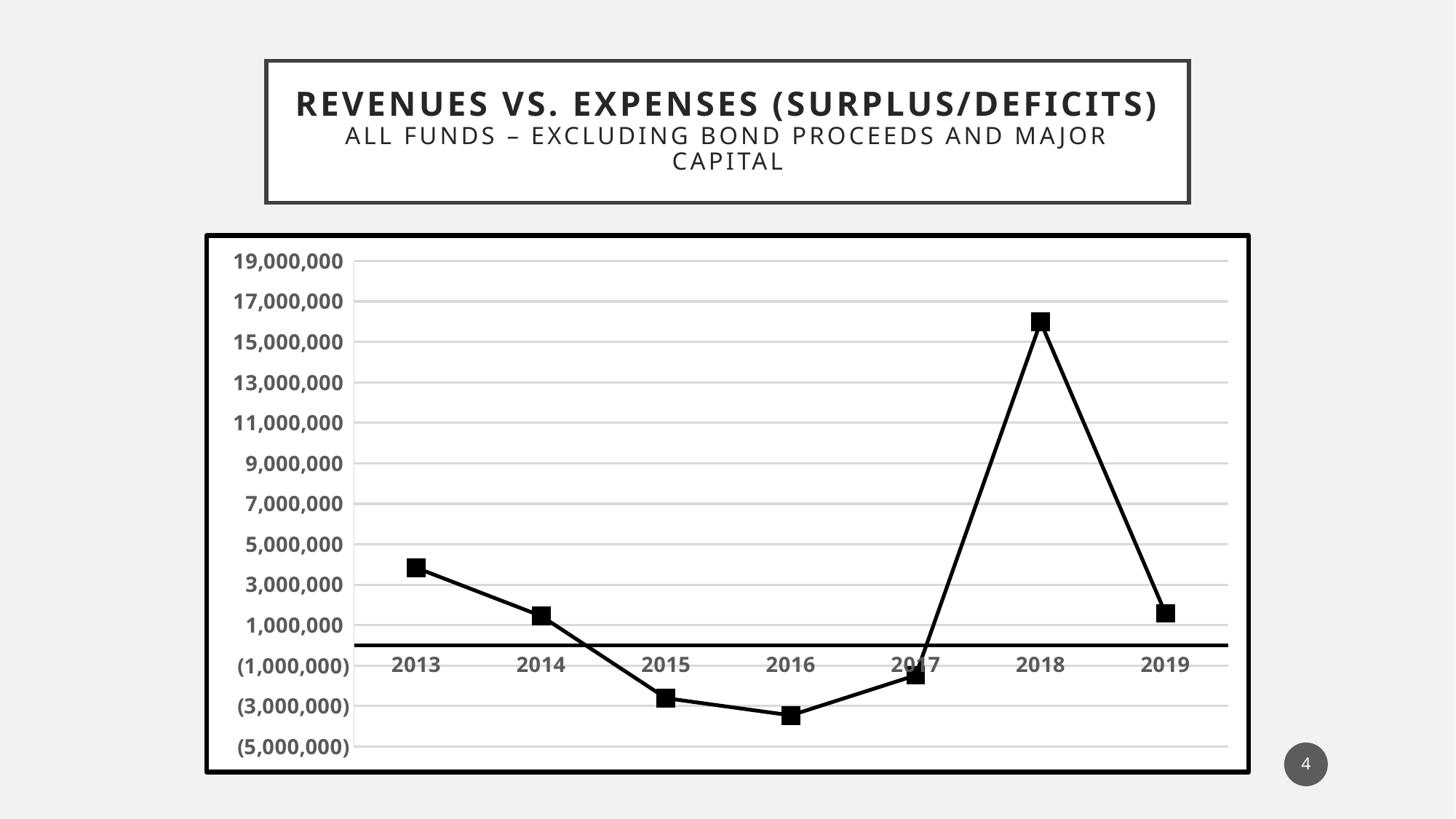
Is the value for 2015 greater or less than 1,000,000? less Which year has the highest value? 2018 Is the value for 2013 greater or less than 3,000,000? greater Is the value for 2016 greater or less than (3,000,000)? less Which year has the lowest value? 2016 What is the title of the slide containing the chart? Revenues vs. Expenses (Surplus/Deficits) Which is larger, the value for 2013 or the value for 2014? 2013 Which is larger, the value for 2018 or the value for 2019? 2018 Do the values rise or fall from 2013 to 2016? fall How many years are plotted on the x axis? 7 What kind of chart is shown on the slide? line chart